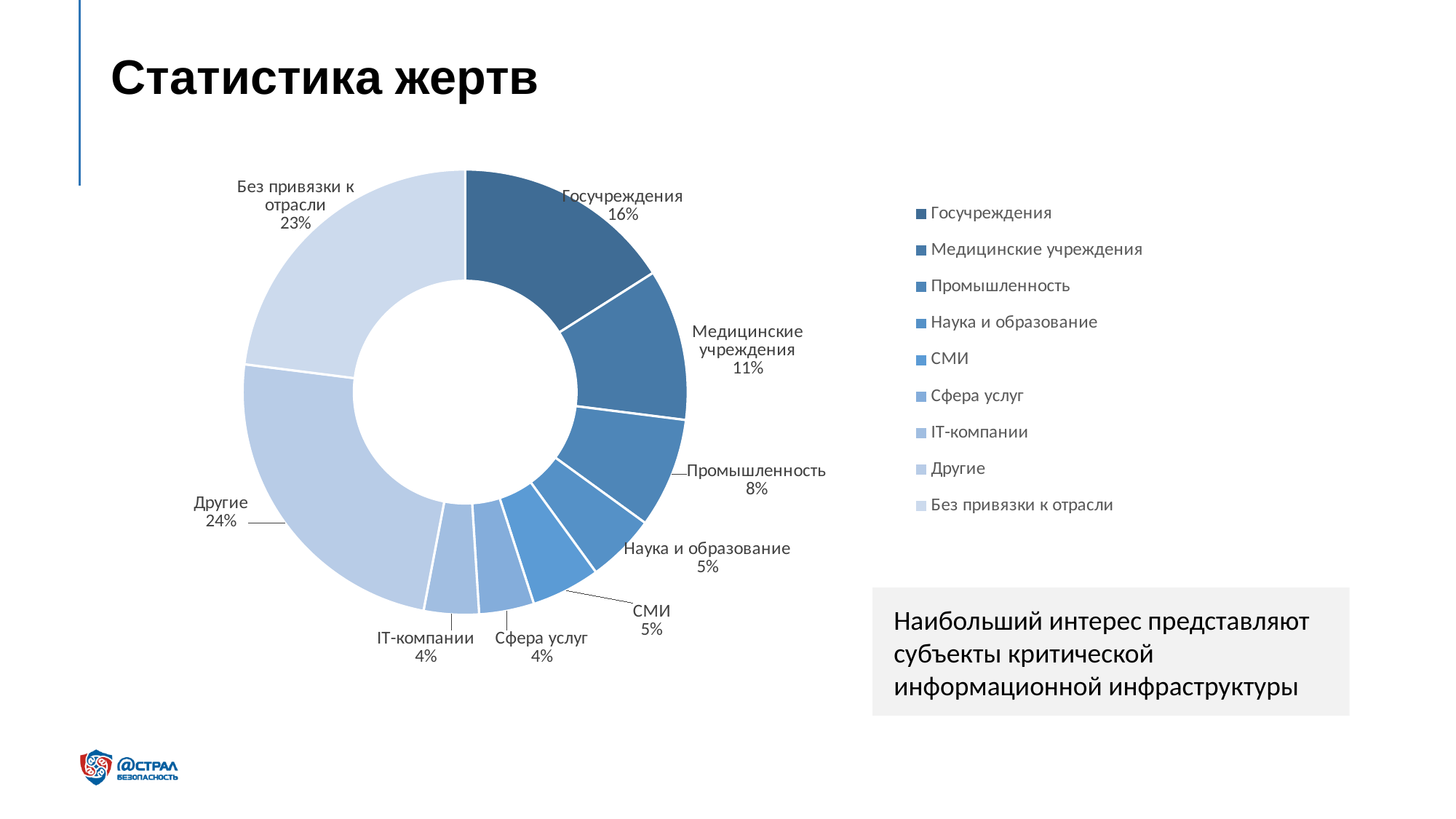
What kind of chart is shown on the slide? doughnut chart What is the value shown for Медицинские учреждения? 11% Which is larger, the share for Медицинские учреждения or the share for Промышленность? Медицинские учреждения What is the combined share of Наука и образование and СМИ? 10% How many categories are shown in the chart? 9 What percentage does the Госучреждения slice represent? 16% Which category has the largest share in the chart? Другие What is the difference in percentage points between Другие and Госучреждения? 8 Which legend entry is listed last? Без привязки к отрасли What percentage is shown for Без привязки к отрасли? 23% What share is labelled for Промышленность? 8% What is the title of the slide containing the chart? Статистика жертв